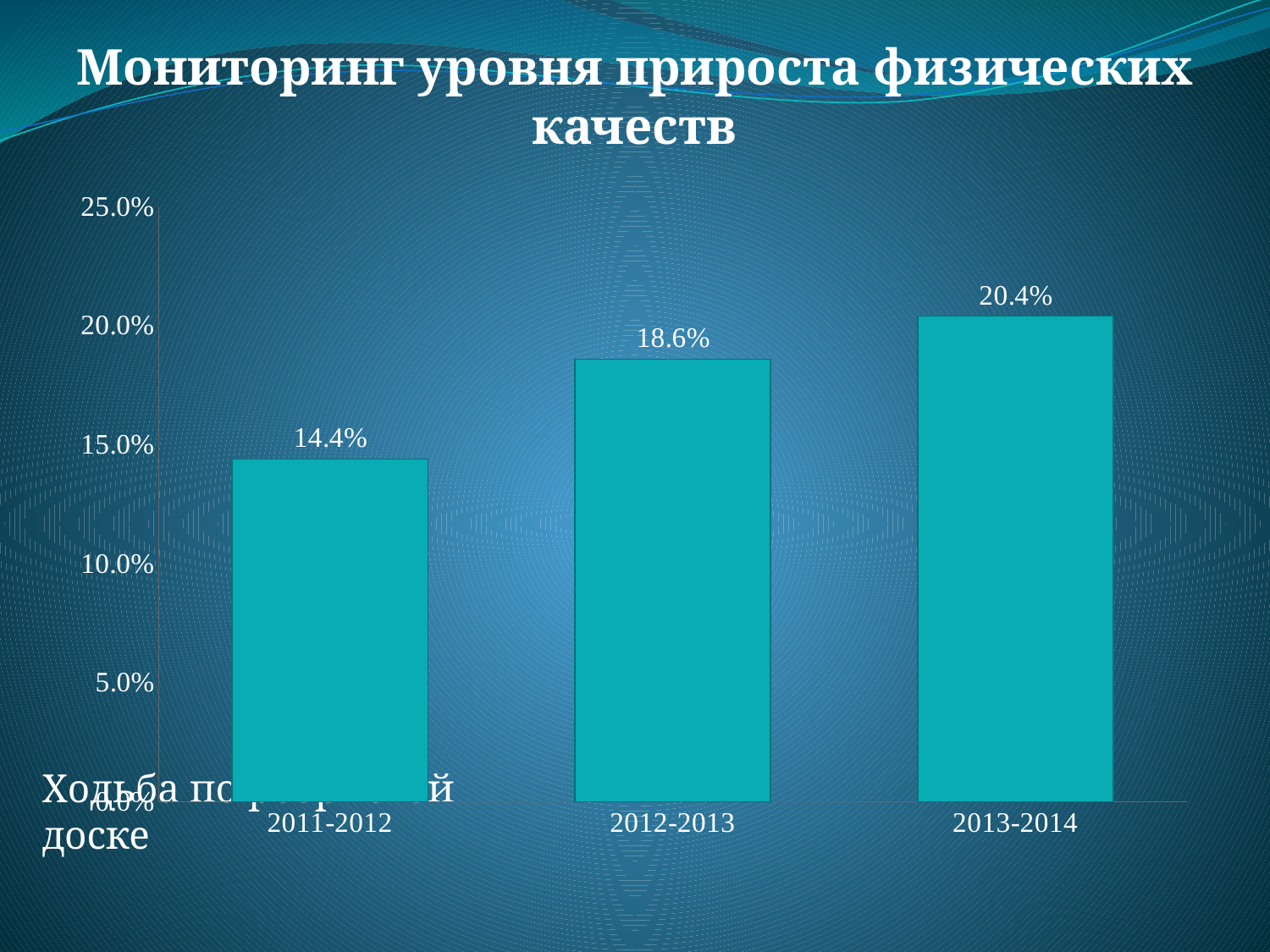
Which period has the highest value? 2013-2014 What is the value for 2012-2013? 18.6% What is the value for 2011-2012? 14.4% What is the difference between the values for 2012-2013 and 2011-2012? 4.2% What kind of chart is shown on the slide? bar chart Do the values rise or fall from 2011-2012 to 2013-2014? rise What is the difference between the values for 2013-2014 and 2011-2012? 6.0% Is the value for 2012-2013 greater or less than 20.0%? less What is the value for 2013-2014? 20.4% Which is larger, the value for 2012-2013 or the value for 2013-2014? 2013-2014 How many periods are shown on the x axis? 3 Which period has the lowest value? 2011-2012